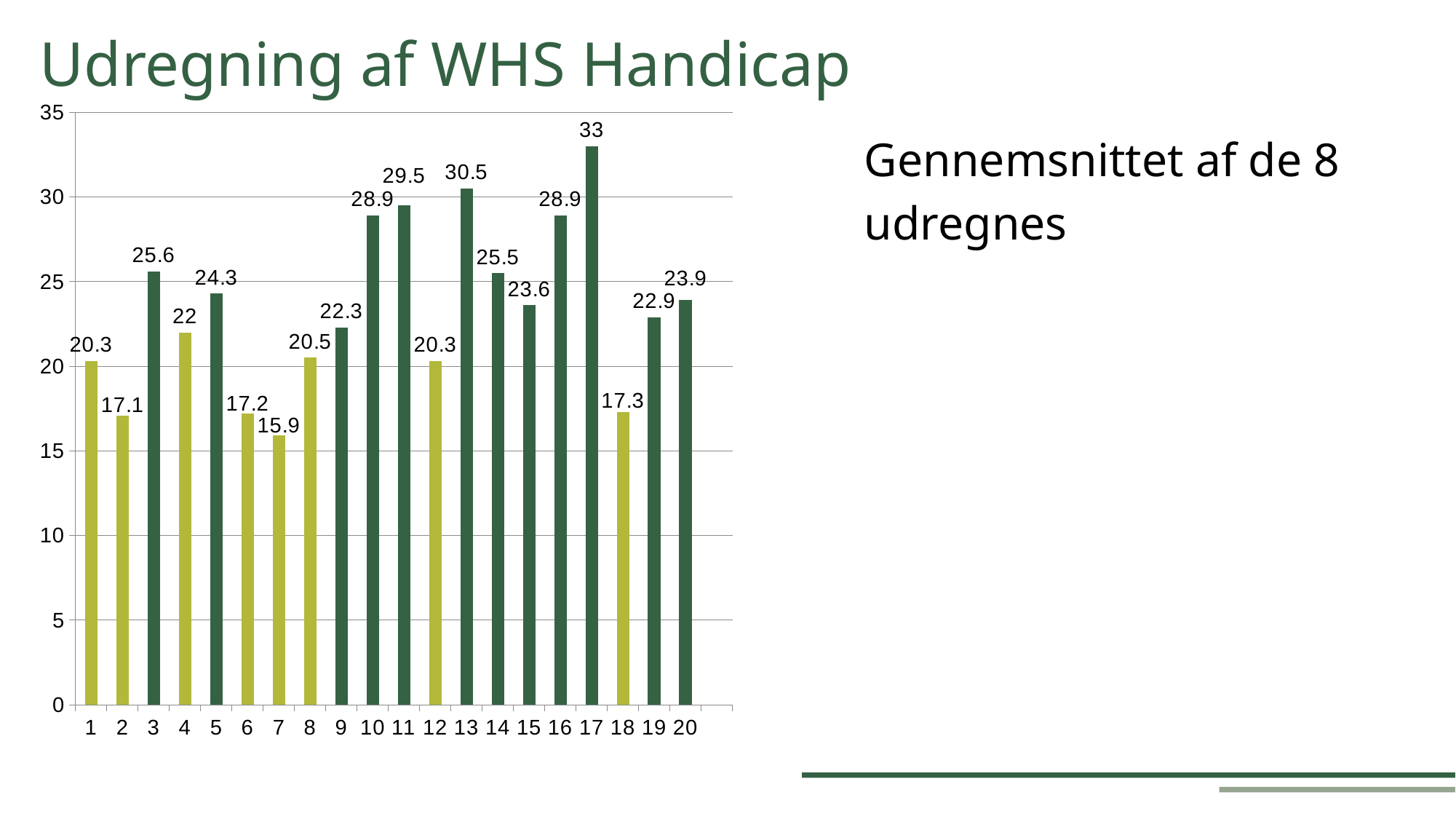
Which category has the highest value? 17 What is the difference between the values for category 3 and category 4? 3.6 Which is larger, the value for category 11 or the value for category 13? 13 Is the value for category 10 greater or less than 25? greater What is the difference between the values for category 17 and category 7? 17.1 How many bars are coloured light green rather than dark green? 8 What is the value for category 13? 30.5 Which category has the lowest value? 7 What is the value for category 17? 33 How many categories are shown on the x axis? 20 What kind of chart is shown on the slide? bar chart What is the value for category 7? 15.9